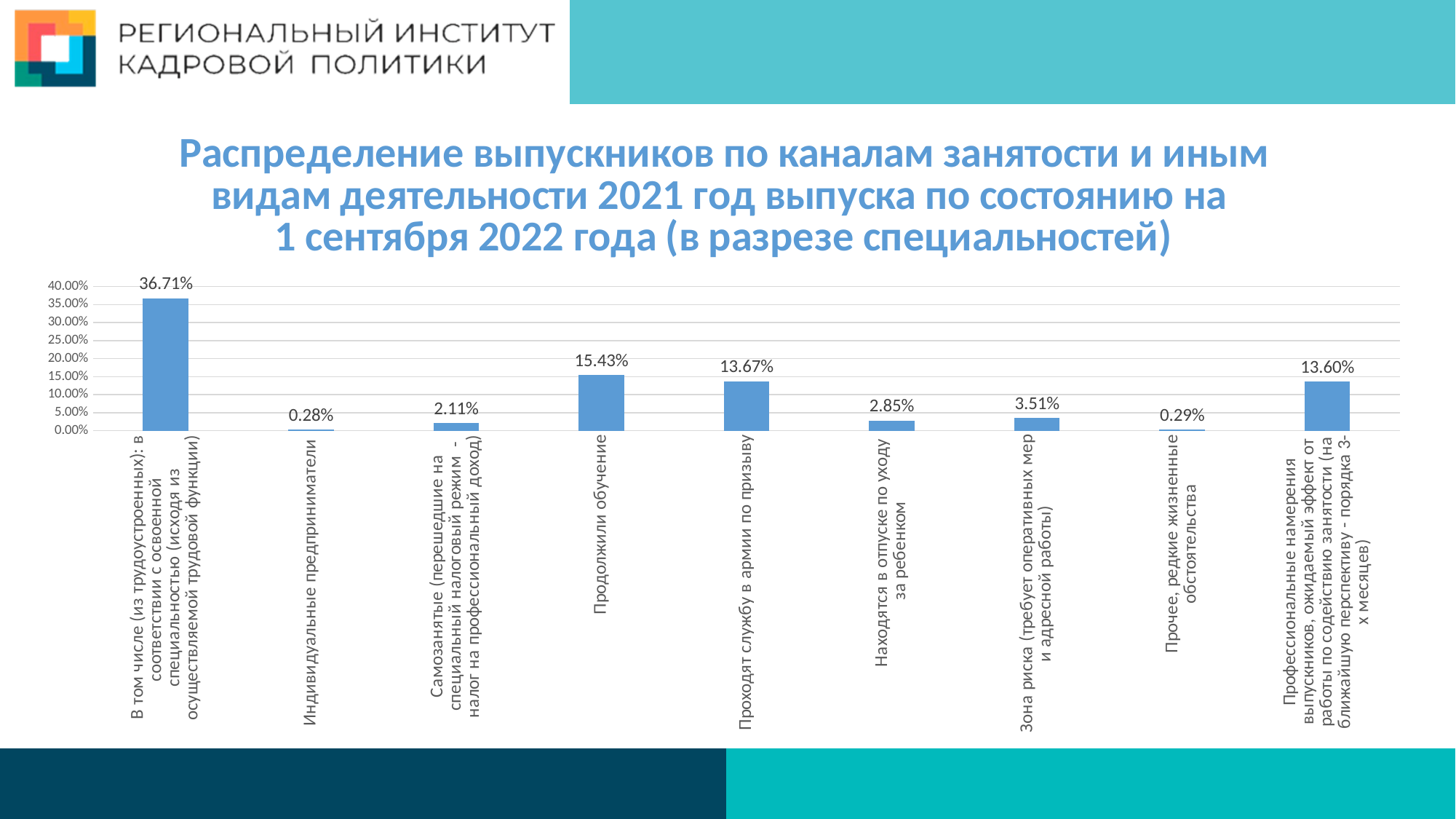
What is the value for «Продолжили обучение»? 15.43% How many categories are shown in the chart? 9 What kind of chart is shown on the slide? bar chart Which category has the highest value? В том числе (из трудоустроенных): в соответствии с освоенной специальностью (исходя из осуществляемой трудовой функции) Is the value for «Профессиональные намерения выпускников» greater or less than 10.00%? greater Which is larger: the value for «Зона риска» or the value for «Самозанятые»? Зона риска What is the difference between the values for «Продолжили обучение» and «Проходят службу в армии по призыву»? 1.76% What is the value for «Проходят службу в армии по призыву»? 13.67% What is the value for «Находятся в отпуске по уходу за ребенком»? 2.85% What is the difference between the values for «Зона риска» and «Находятся в отпуске по уходу за ребенком»? 0.66% What is the value for «Индивидуальные предприниматели»? 0.28% What is the value for «Зона риска (требует оперативных мер и адресной работы)»? 3.51%